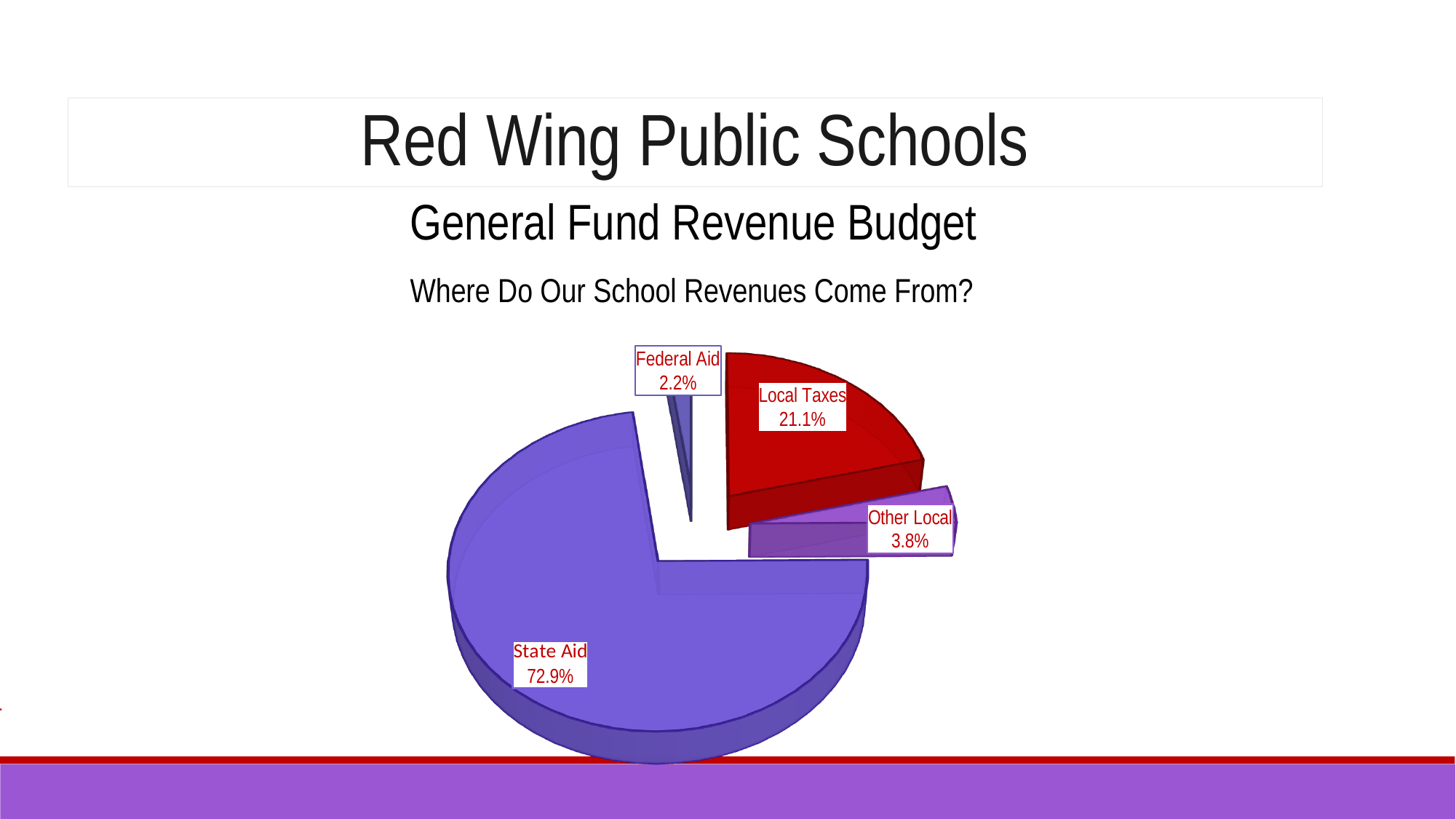
What share of revenue comes from Local Taxes? 21.1% What share of revenue comes from Federal Aid? 2.2% Which revenue source has the smallest share? Federal Aid How many slices does the pie chart have? 4 What share of revenue comes from State Aid? 72.9% What share of revenue comes from Other Local? 3.8% Which is larger, Other Local or Federal Aid? Other Local What is the combined share of Local Taxes and Other Local? 24.9% Which revenue source has the largest share? State Aid What is the difference in percentage points between State Aid and Local Taxes? 51.8 What kind of chart is shown on the slide? pie chart What question does the chart's subtitle ask? Where Do Our School Revenues Come From?